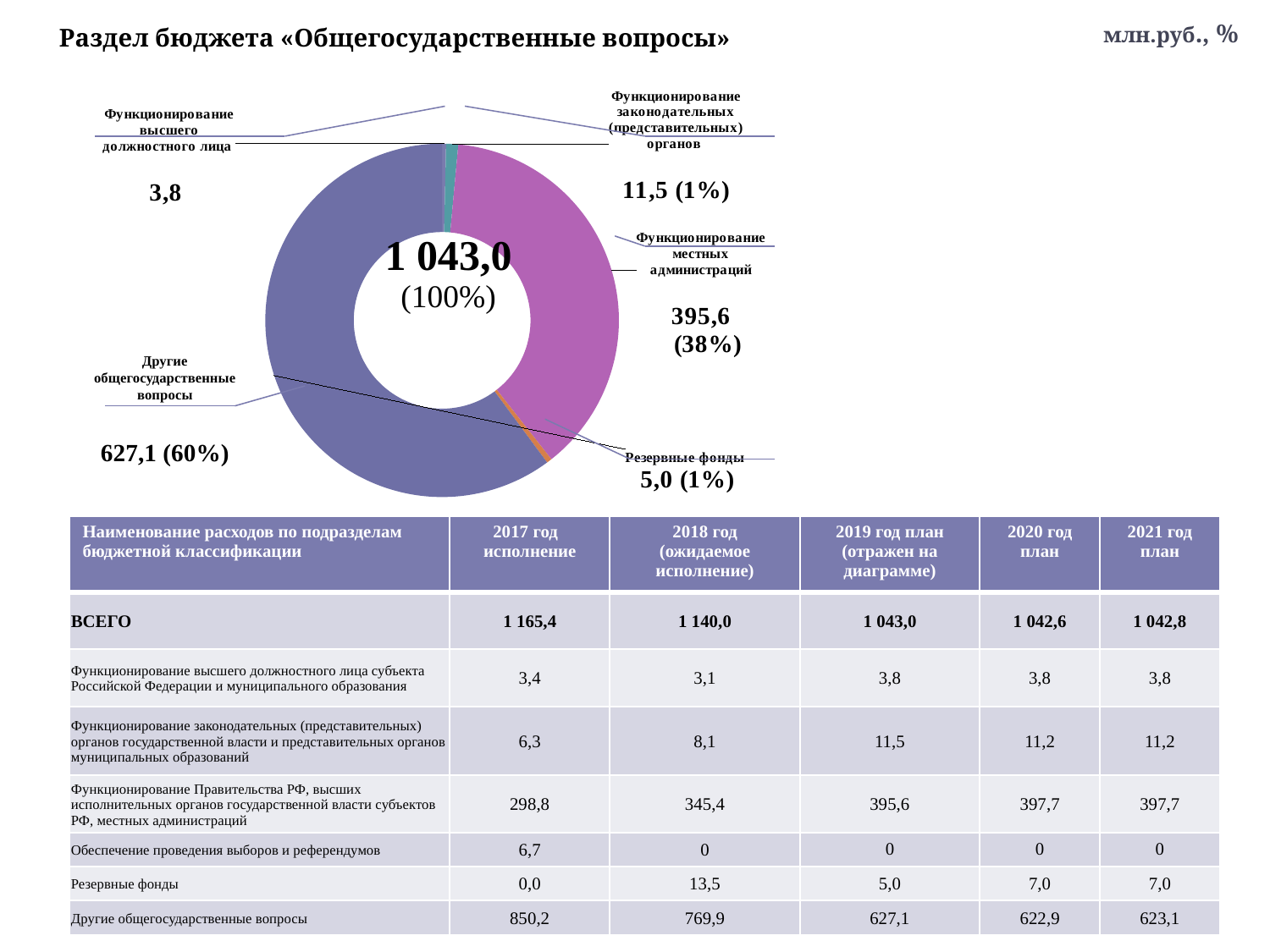
What share of the chart does «Функционирование местных администраций» represent? 38% Which category has the smallest value on the chart? Функционирование высшего должностного лица What is the value shown for «Другие общегосударственные вопросы» on the chart? 627,1 What is the value shown for «Функционирование высшего должностного лица» on the chart? 3,8 What is the value shown for «Функционирование законодательных (представительных) органов» on the chart? 11,5 What share of the chart does «Другие общегосударственные вопросы» represent? 60% What is the value shown for «Резервные фонды» on the chart? 5,0 What is the value shown for «Функционирование местных администраций» on the chart? 395,6 What is the difference between the values for «Другие общегосударственные вопросы» and «Функционирование местных администраций» on the chart? 231,5 What kind of chart is shown on the slide? Pie (donut) chart What total value is shown in the centre of the chart? 1 043,0 Which category has the largest value on the chart? Другие общегосударственные вопросы